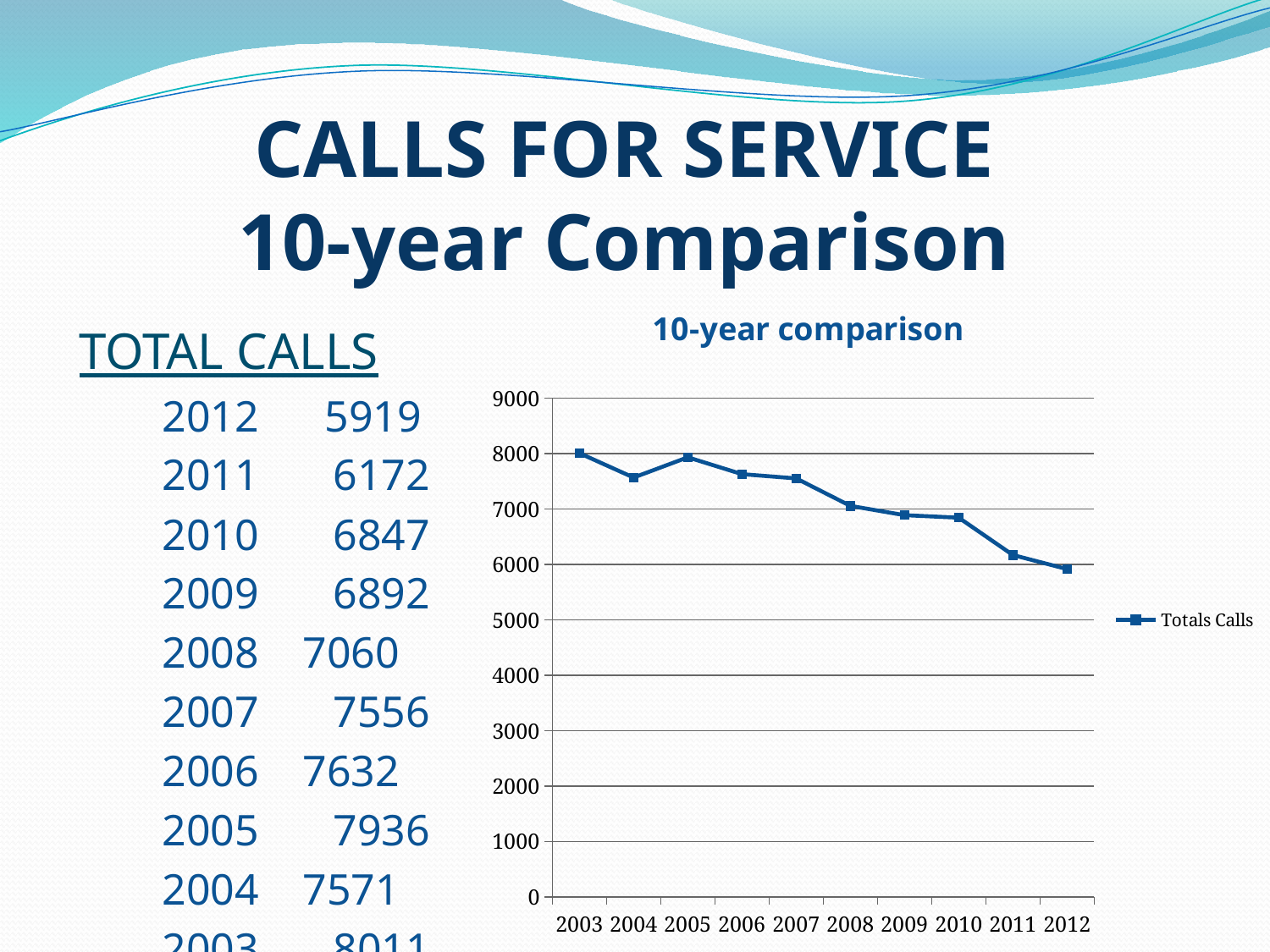
Which year has the highest number of total calls? 2003 What is the name of the series shown in the chart legend? Totals Calls What is the number of total calls for 2012? 5919 How many years are plotted along the x axis of the chart? 10 What kind of chart is shown on the slide? line chart What is the title of the chart? 10-year comparison Which year has the lowest number of total calls? 2012 What is the number of total calls for 2005? 7936 Is the value for 2009 greater or less than 7000? less Which year has more total calls, 2005 or 2004? 2005 How many series does the chart legend list? 1 Do the total calls generally rise or fall from 2003 to 2012? fall